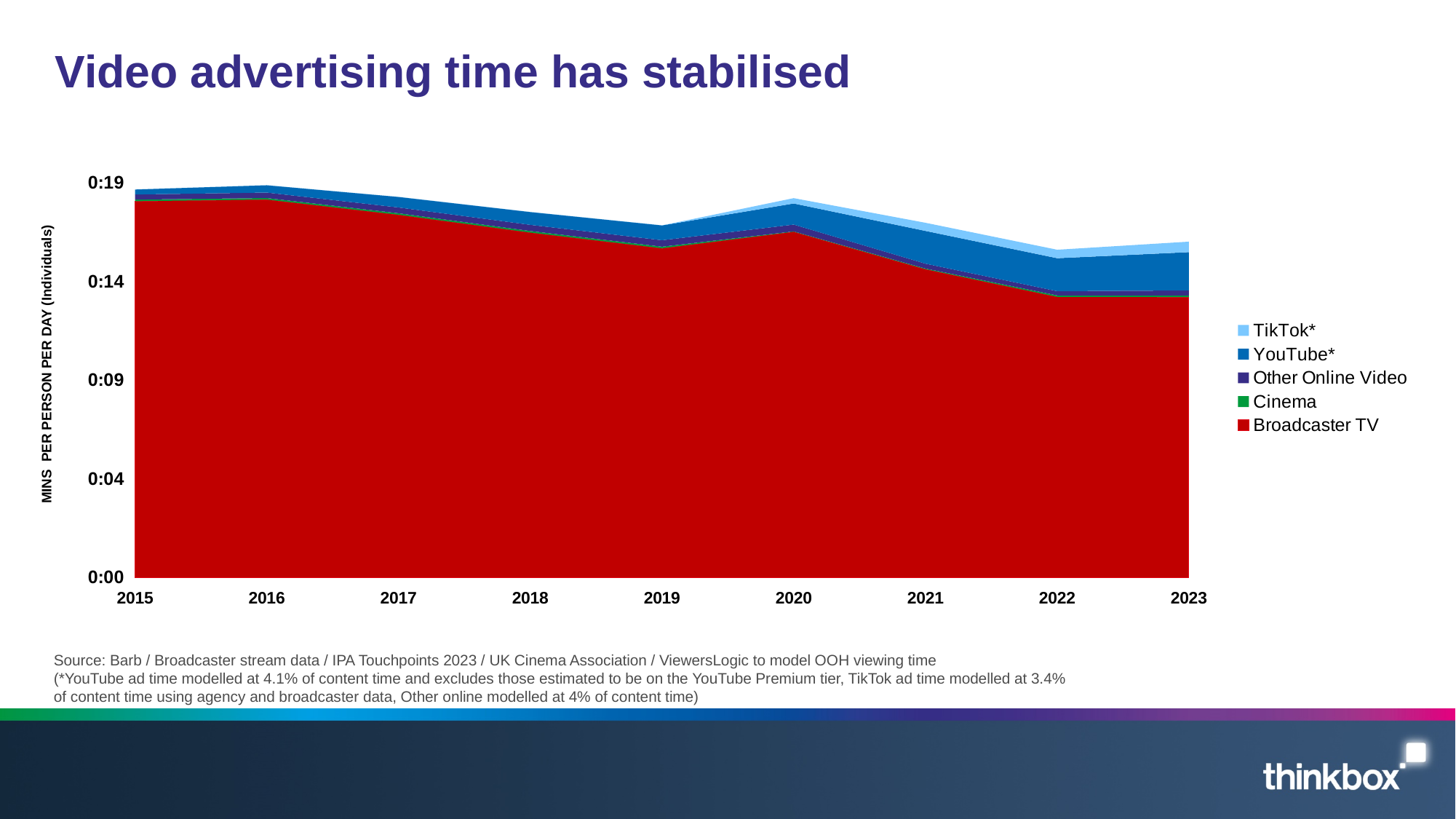
Which series accounts for the largest share of video advertising time in every year? Broadcaster TV Which is larger, the Broadcaster TV value in 2016 or in 2023? 2016 Does the Broadcaster TV value rise or fall between 2020 and 2022? fall What is the label on the y axis? MINS PER PERSON PER DAY (Individuals) Is the total video advertising time in 2023 greater or less than 0:14? greater How many series does the legend list? 5 Is the value for Broadcaster TV in 2015 greater or less than 0:14? greater Is the value for Broadcaster TV in 2019 greater or less than 0:14? greater How many years are plotted along the x axis? 9 What kind of chart is shown on the slide? Stacked area chart What is the title of the slide? Video advertising time has stabilised